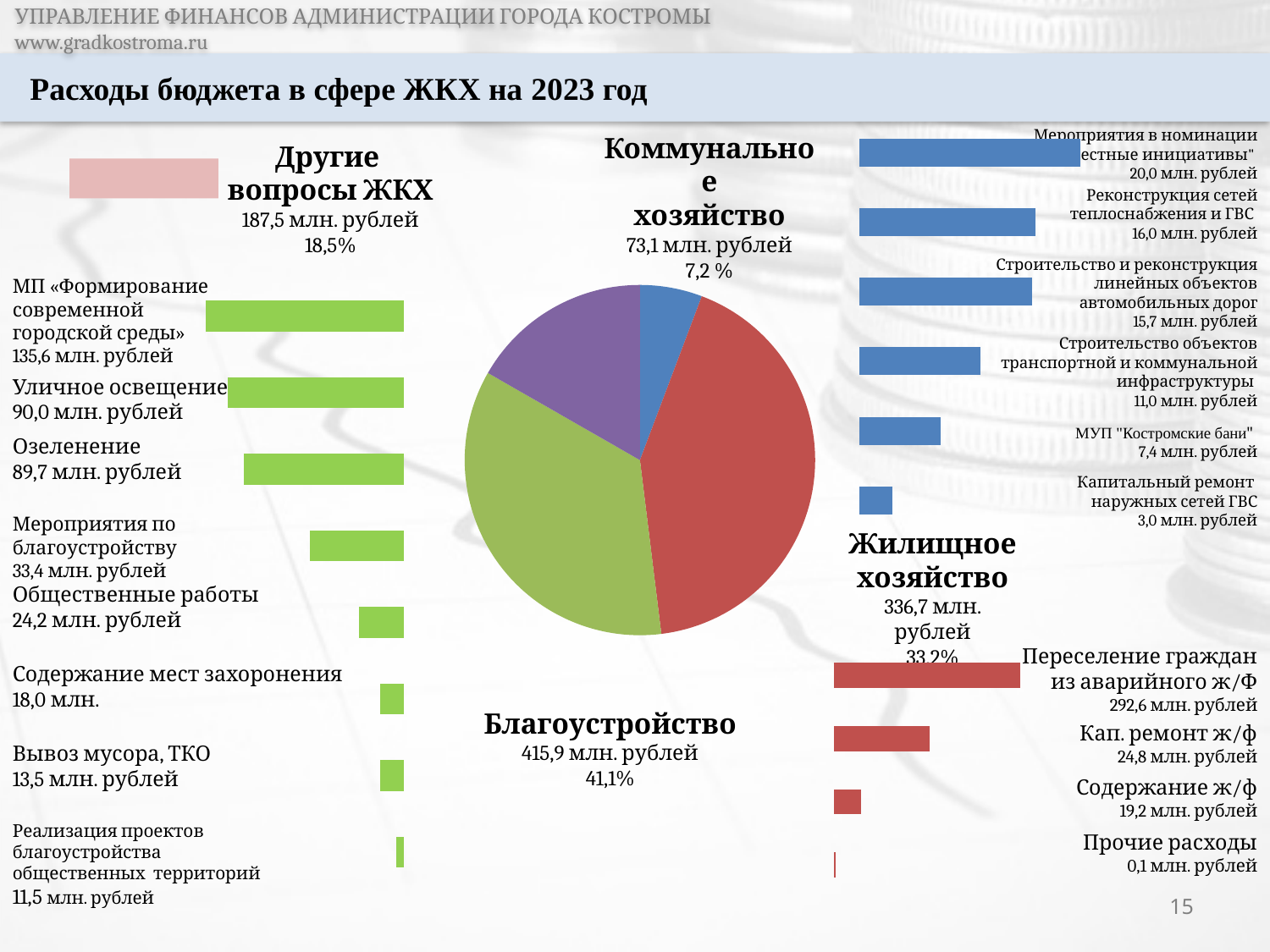
On the pie chart in the centre of the slide, which category has the largest share? Благоустройство On the green bar chart on the left of the slide, which is larger: Озеленение or Мероприятия по благоустройству? Озеленение On the pie chart in the centre of the slide, which category has the smallest share? Коммунальное хозяйство On the pie chart in the centre of the slide, what share of the budget goes to Благоустройство? 41,1% On the green bar chart on the left of the slide, what is the value for Уличное освещение? 90,0 млн. рублей On the blue bar chart at the top right of the slide, what is the value for Реконструкция сетей теплоснабжения и ГВС? 16,0 млн. рублей On the blue bar chart at the top right of the slide, which category has the lowest value? Капитальный ремонт наружных сетей ГВС How many slices does the pie chart in the centre of the slide have? 4 On the red bar chart at the bottom right of the slide, what is the value for Переселение граждан из аварийного ж/Ф? 292,6 млн. рублей On the green bar chart on the left of the slide, which category has the highest value? МП «Формирование современной городской среды» On the pie chart in the centre of the slide, what is the difference in млн. рублей between Благоустройство and Жилищное хозяйство? 79,2 млн. рублей On the pie chart in the centre of the slide, what is the value for Жилищное хозяйство? 336,7 млн. рублей